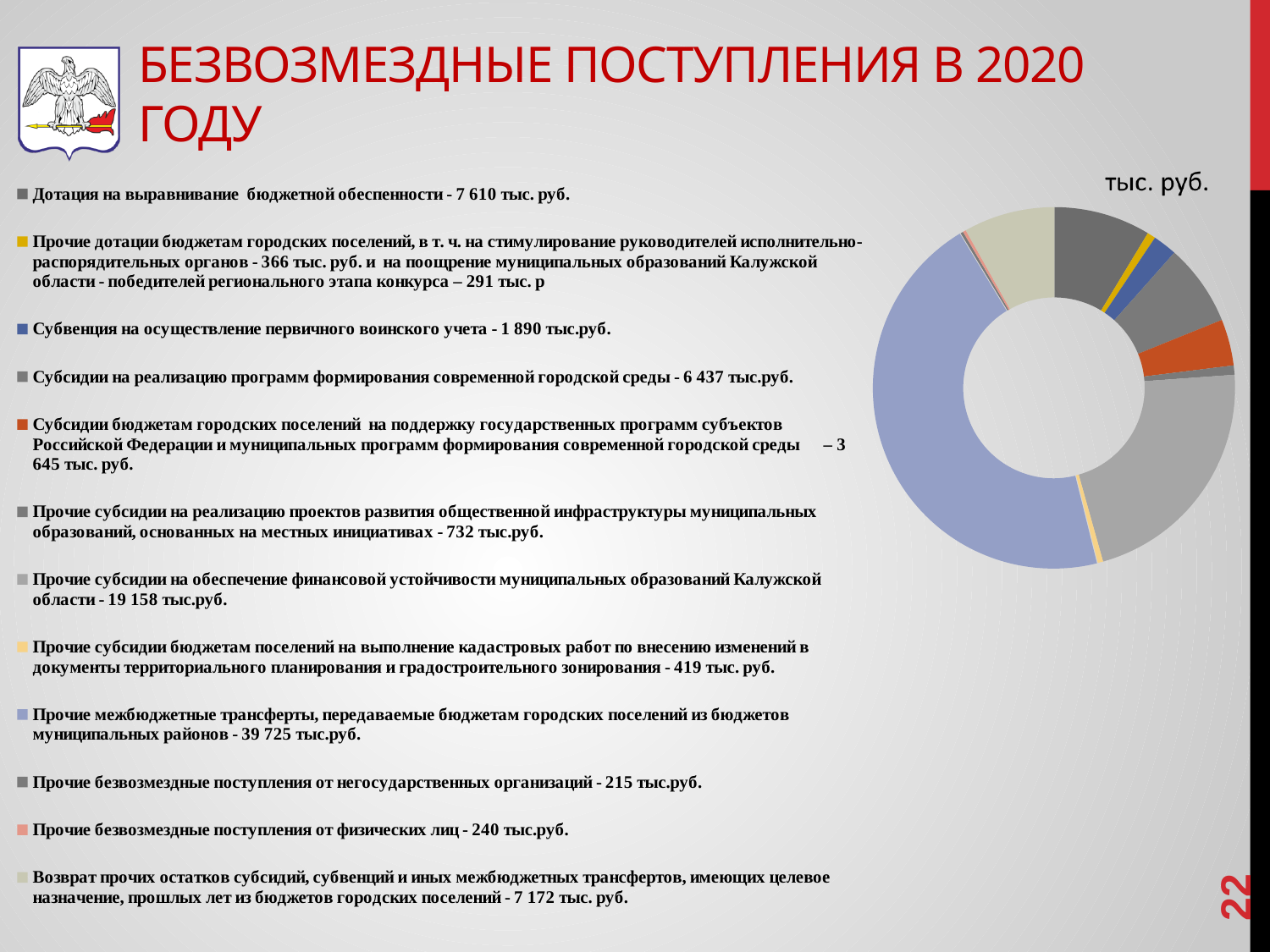
What is the difference between 'Прочие межбюджетные трансферты' (39 725) and 'Прочие субсидии на обеспечение финансовой устойчивости' (19 158)? 20 567 тыс.руб. Which category has the smallest value in the chart? Прочие безвозмездные поступления от негосударственных организаций What kind of chart is shown on the slide? Pie (doughnut) chart How many categories does the chart legend list? 12 What is the value for 'Дотация на выравнивание бюджетной обеспеченности'? 7 610 тыс. руб. Which category has the largest value in the chart? Прочие межбюджетные трансферты, передаваемые бюджетам городских поселений из бюджетов муниципальных районов What is the value for 'Субвенция на осуществление первичного воинского учета'? 1 890 тыс.руб. What is the value for 'Прочие межбюджетные трансферты, передаваемые бюджетам городских поселений из бюджетов муниципальных районов'? 39 725 тыс.руб. Which is larger: 'Дотация на выравнивание бюджетной обеспеченности' or 'Возврат прочих остатков субсидий, субвенций и иных межбюджетных трансфертов'? Дотация на выравнивание бюджетной обеспеченности What is the value for 'Прочие субсидии на обеспечение финансовой устойчивости муниципальных образований Калужской области'? 19 158 тыс.руб. What is the difference between 'Субсидии на реализацию программ формирования современной городской среды' (6 437) and 'Субсидии бюджетам городских поселений на поддержку государственных программ' (3 645)? 2 792 тыс.руб. What unit is shown next to the chart? тыс. руб.